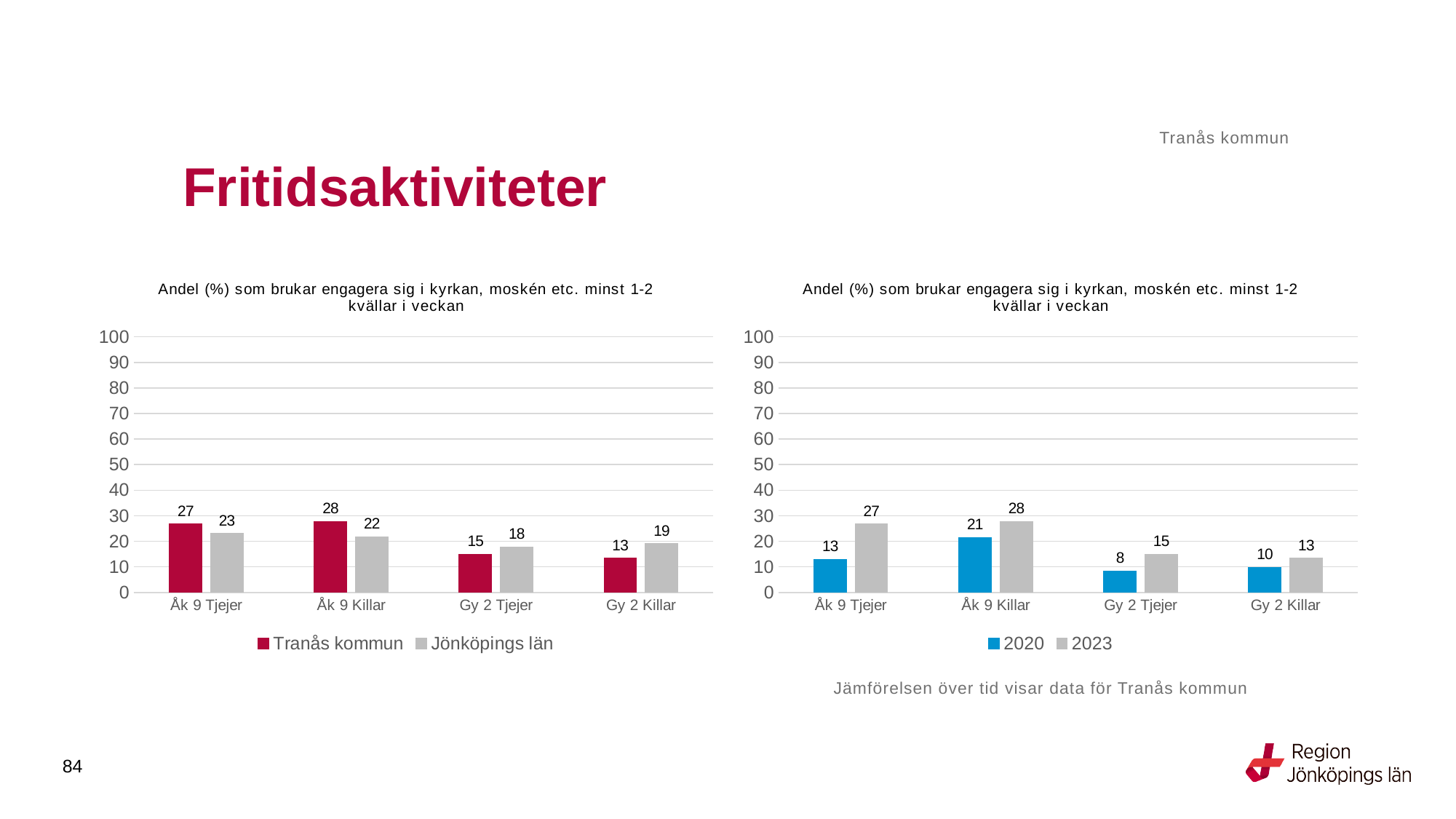
In the right chart, which category has the lowest value for 2020? Gy 2 Tjejer In the right chart, what is the value for 2023 for Åk 9 Killar? 28 How many series does the legend of the right chart list? 2 In the left chart, what is the value for Tranås kommun for Åk 9 Tjejer? 27 In the right chart, what is the value for 2020 for Gy 2 Tjejer? 8 What kind of chart is the left chart? Bar chart In the right chart, what is the difference between 2023 and 2020 for Åk 9 Tjejer? 14 In the left chart, which category has the highest value for Tranås kommun? Åk 9 Killar In the left chart, what is the value for Jönköpings län for Gy 2 Killar? 19 In the left chart, what is the difference between Tranås kommun and Jönköpings län for Åk 9 Killar? 6 In the left chart, which category has the lowest value for Tranås kommun? Gy 2 Killar In the left chart, which is larger for Gy 2 Tjejer: Tranås kommun or Jönköpings län? Jönköpings län